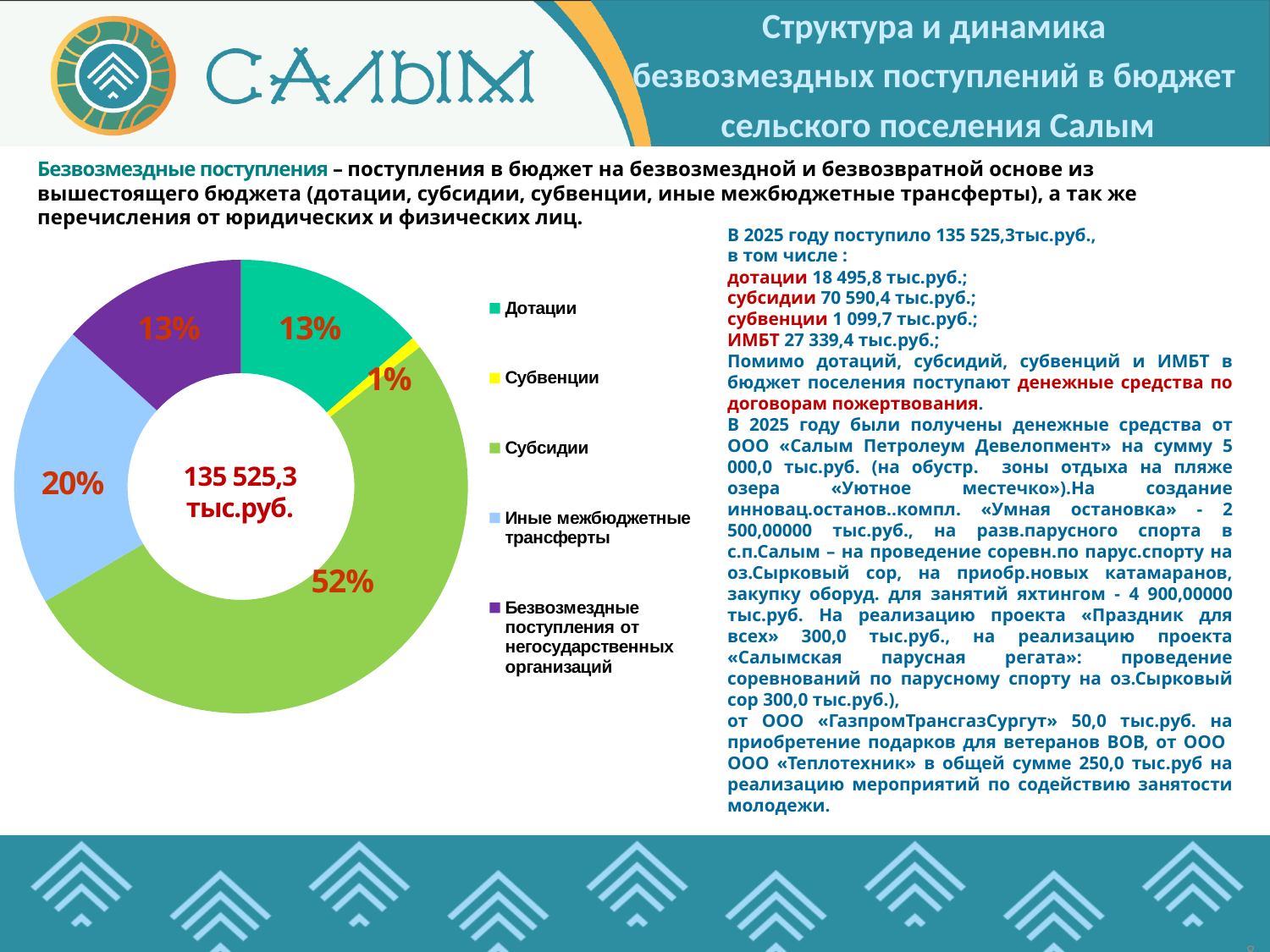
What kind of chart is shown on the slide? Pie chart (doughnut) What share of the pie chart is labelled for Субвенции? 1% What total value is printed in the centre of the pie chart? 135 525,3 тыс.руб. Which has a larger share in the pie chart, Иные межбюджетные трансферты or Дотации? Иные межбюджетные трансферты Which legend entry is shown in yellow in the pie chart? Субвенции How many categories does the pie chart's legend list? 5 What share of the pie chart is labelled for Дотации? 13% Which category has the smallest share in the pie chart? Субвенции Which category has the largest share in the pie chart? Субсидии What is the difference in percentage points between the shares of Субсидии and Иные межбюджетные трансферты? 32 What share of the pie chart is labelled for Субсидии? 52% What share of the pie chart is labelled for Иные межбюджетные трансферты? 20%